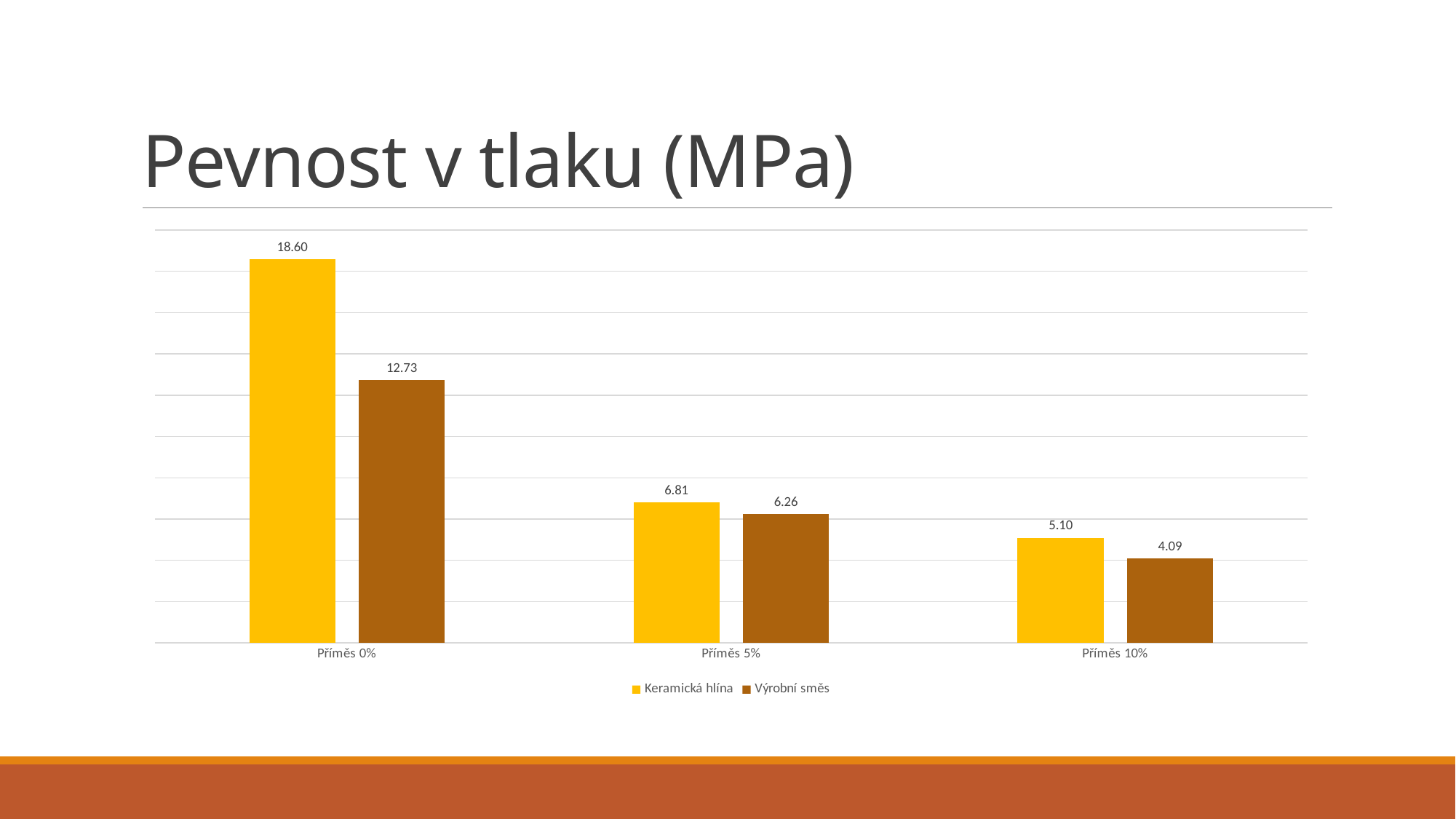
What is the value for Keramická hlína at Příměs 0%? 18.60 How many series does the legend list? 2 What is the difference between Keramická hlína and Výrobní směs at Příměs 0%? 5.87 What is the value for Výrobní směs at Příměs 10%? 4.09 Which category has the lowest value for Výrobní směs? Příměs 10% Do the values for Výrobní směs rise or fall from Příměs 0% to Příměs 10%? Fall What kind of chart is shown on the slide? Bar chart What is the difference between Keramická hlína at Příměs 5% and at Příměs 10%? 1.71 What is the value for Výrobní směs at Příměs 5%? 6.26 How many categories are shown on the x axis? 3 Which is larger at Příměs 10%: Keramická hlína or Výrobní směs? Keramická hlína Which category has the highest value for Keramická hlína? Příměs 0%